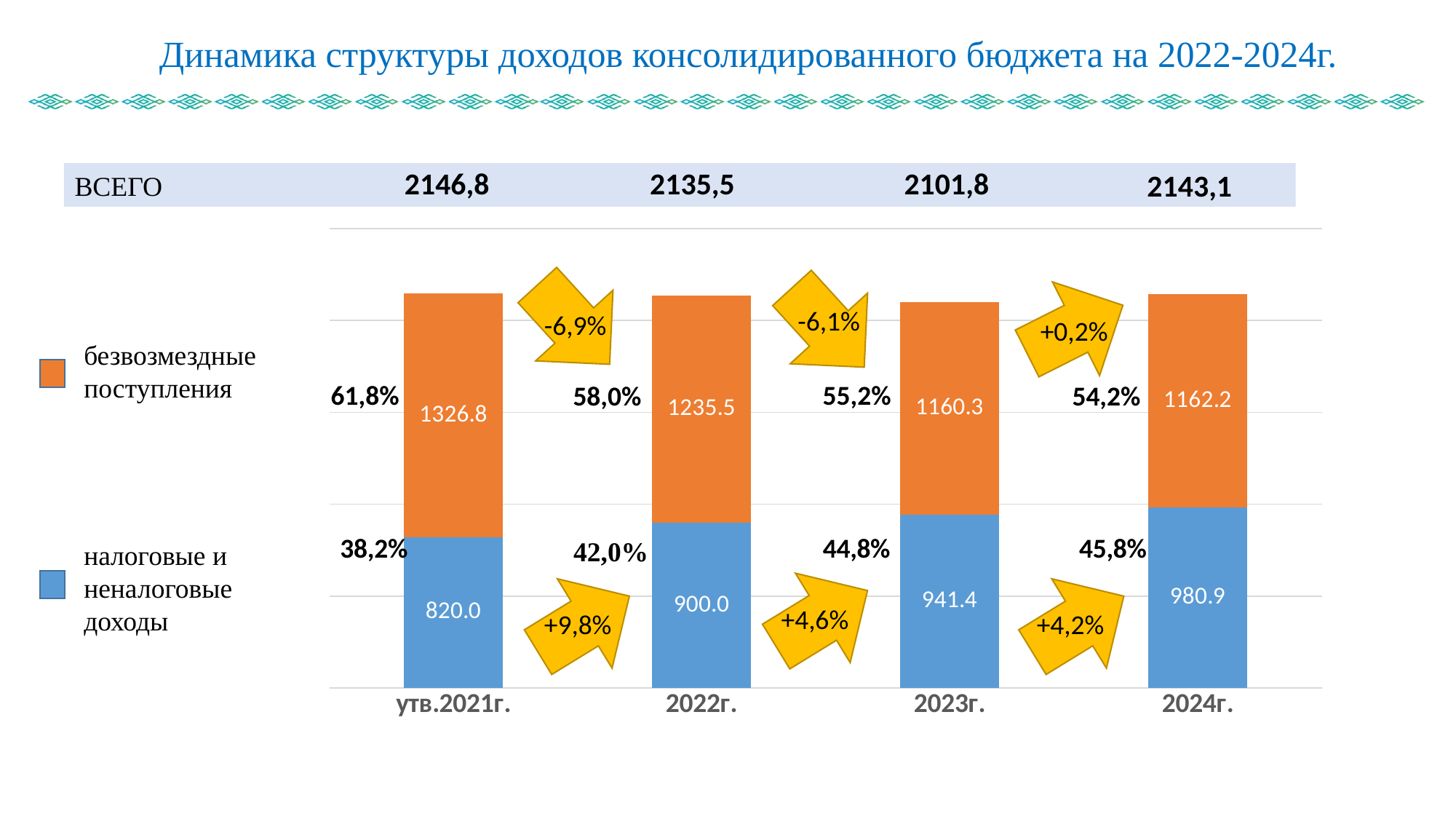
In which year is налоговые и неналоговые доходы highest? 2024г. How many years (categories) are shown on the x axis? 4 In which year is безвозмездные поступления lowest? 2023г. What is the value of безвозмездные поступления for утв.2021г.? 1326.8 What is the value of безвозмездные поступления for 2023г.? 1160.3 What is the total (ВСЕГО) of the stacked bar for 2023г.? 2101,8 Do the values for налоговые и неналоговые доходы rise or fall from утв.2021г. to 2024г.? rise What is the difference between налоговые и неналоговые доходы in 2022г. and утв.2021г.? 80.0 Which is larger in 2022г.: безвозмездные поступления or налоговые и неналоговые доходы? безвозмездные поступления How many series does the legend list? 2 What is the value of налоговые и неналоговые доходы for 2024г.? 980.9 What kind of chart is shown on the slide? stacked bar chart